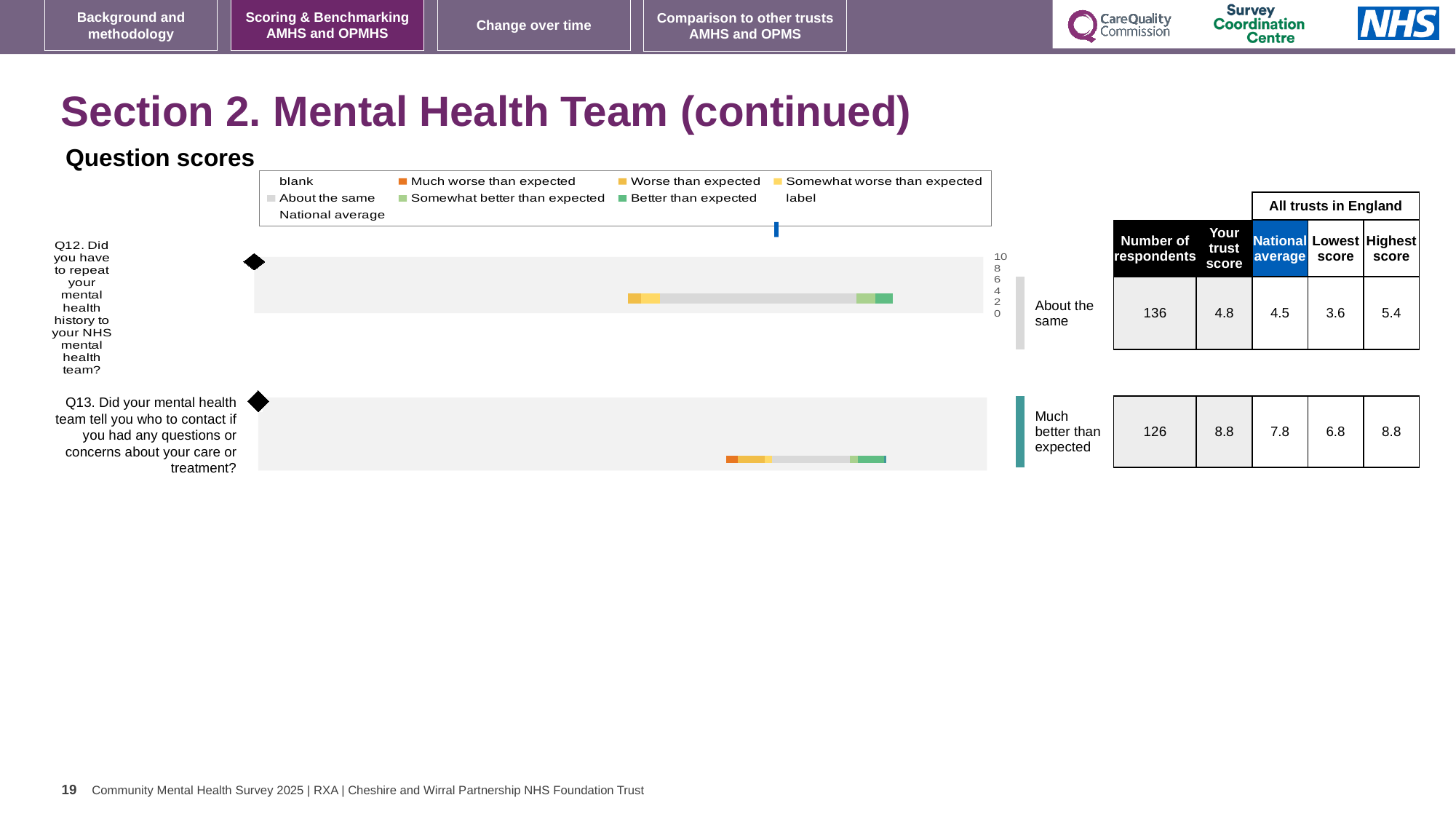
Which question has the higher trust score, Q12 or Q13? Q13 How many questions are plotted on the slide? 2 What kind of chart is used to show the benchmarking for Q12 and Q13? bar chart What is the trust score for Q12 shown in the table beside the chart? 4.8 Which colour in the legend represents 'Much worse than expected'? orange What benchmark rating is shown next to the Q13 chart? Much better than expected What is the difference between the highest score and the lowest score for Q12? 1.8 What is the national average for Q13 shown in the table beside the chart? 7.8 How many respondents answered Q12? 136 For Q13, which is larger: the trust score or the national average? trust score How many entries does the legend above the charts list? 9 What benchmark rating is shown next to the Q12 chart? About the same